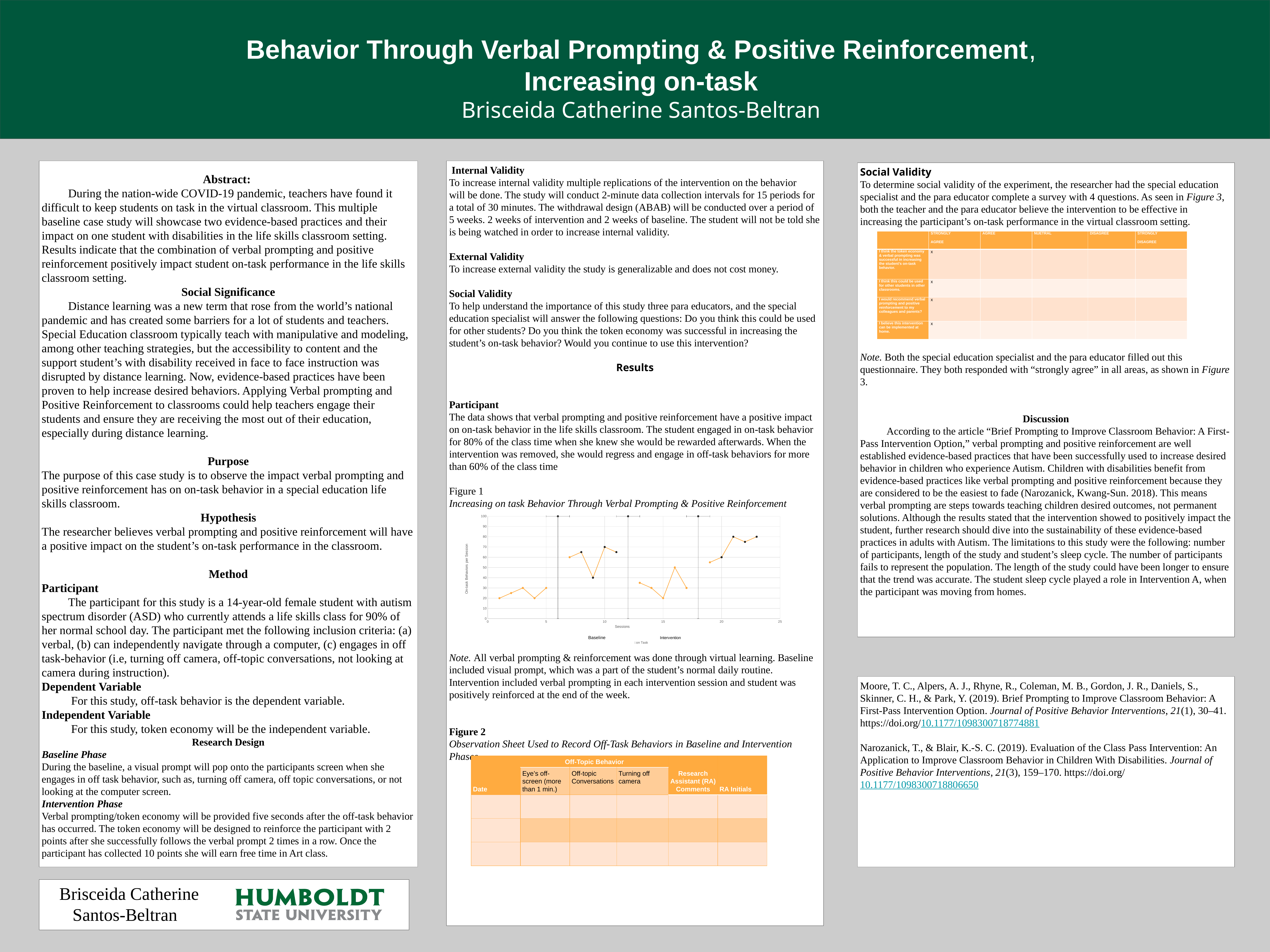
In Figure 1, what is the title of the y axis? On-task Behaviors per Session In Figure 1, which has the higher value: session 9 or session 21? Session 21 In Figure 1, is the value for session 10 greater or less than 60? greater In Figure 1, do the values generally rise or fall from session 19 to session 23? Rise In Figure 1, is the value for session 15 greater or less than 30? less In Figure 1, which has the higher value: session 3 or session 8? Session 8 In Figure 1, what is the title of the x axis? Sessions In Figure 1, is the value for session 8 greater or less than 50? greater What kind of chart is Figure 1, "Increasing on task Behavior Through Verbal Prompting & Positive Reinforcement"? Line chart